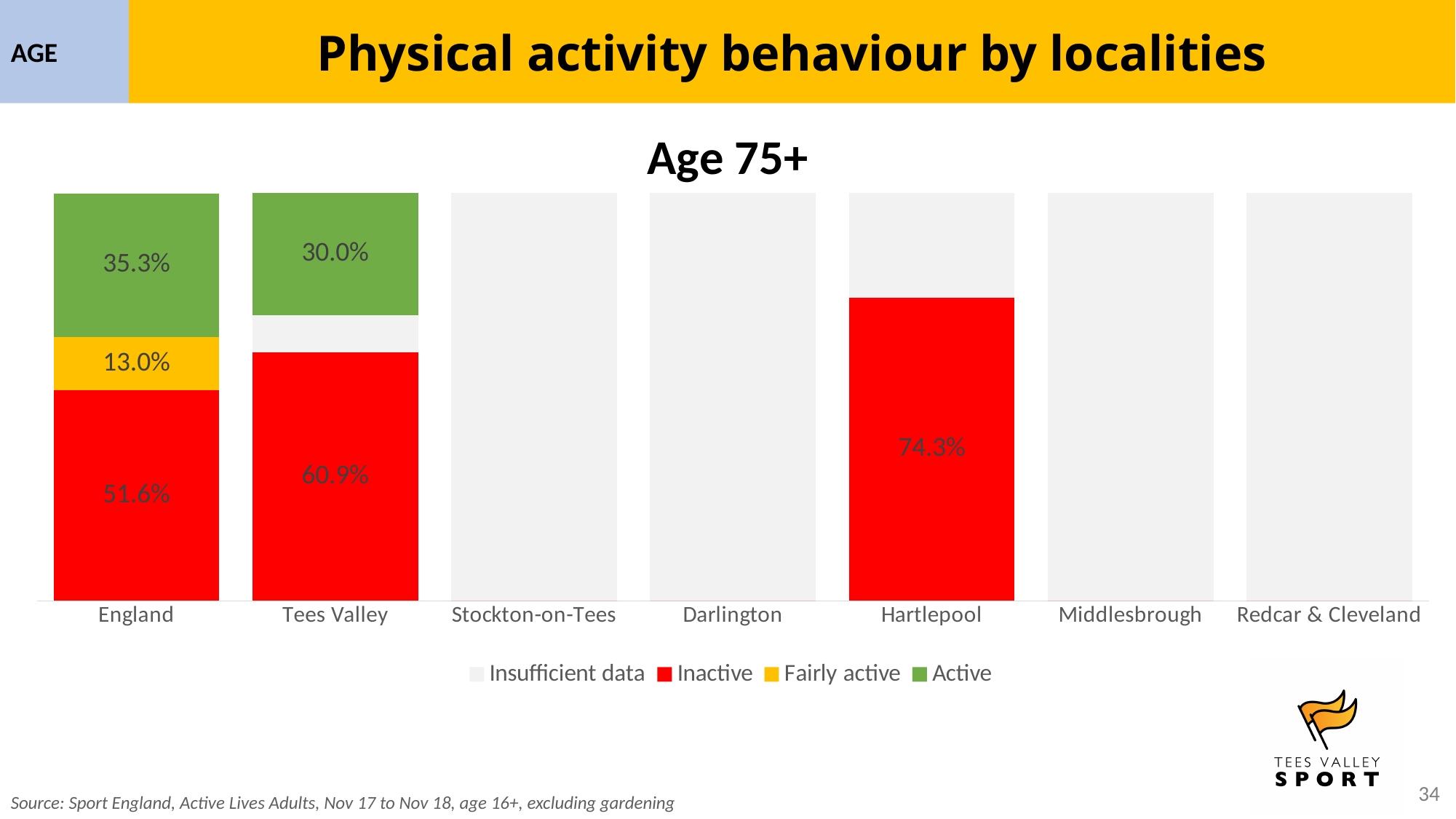
Which has a larger Inactive value, England or Tees Valley? Tees Valley What is the Active value for Tees Valley? 30.0% What is the difference between the Inactive values for Tees Valley and England? 9.3 percentage points What is the Fairly active value for England? 13.0% How many localities are shown on the x axis? 7 What kind of chart is shown on the slide? Stacked bar chart What is the Inactive value for Hartlepool? 74.3% How many series does the legend list? 4 What is the Inactive value for England? 51.6% What is the difference between the Active values for England and Tees Valley? 5.3 percentage points Which locality has the highest labelled Inactive value? Hartlepool What is the title of the chart? Age 75+